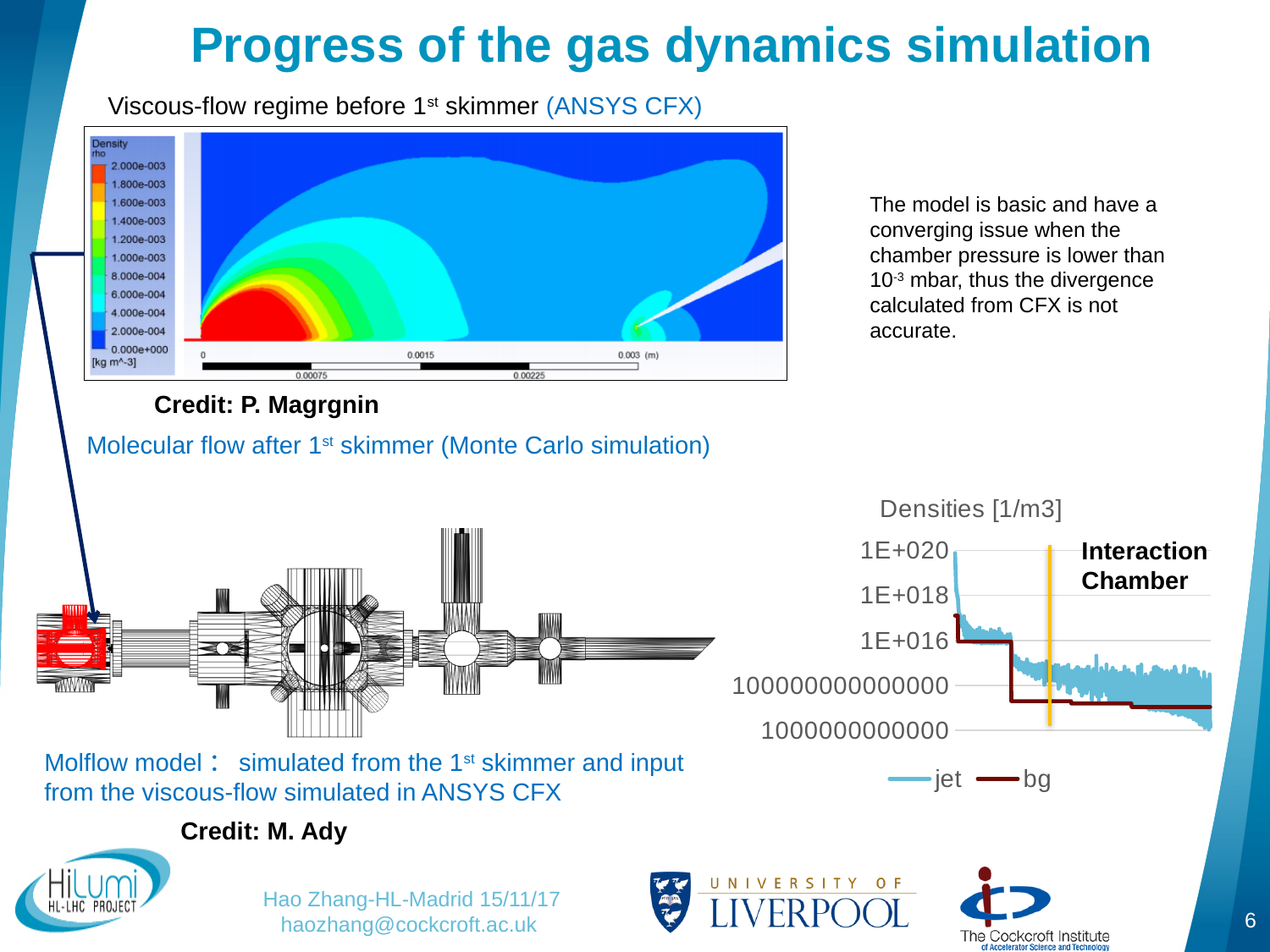
In the 'Densities [1/m3]' chart, do the bg values rise or fall from left to right along the x axis? fall In the 'Densities [1/m3]' chart, which series is higher at the vertical 'Interaction Chamber' marker, jet or bg? jet In the 'Densities [1/m3]' chart, is the jet value at the far left of the plot greater or less than 1E+018? greater How many tick labels are shown on the y axis of the 'Densities [1/m3]' chart? 5 How many series does the legend of the 'Densities [1/m3]' chart list? 2 What label is written next to the vertical orange marker line in the 'Densities [1/m3]' chart? Interaction Chamber In the 'Densities [1/m3]' chart, do the jet values rise or fall from left to right along the x axis? fall In the 'Densities [1/m3]' chart, is the bg value at the far right of the plot greater or less than 1E+016? less What kind of chart is the 'Densities [1/m3]' chart? line chart What are the two series named in the legend of the 'Densities [1/m3]' chart? jet and bg